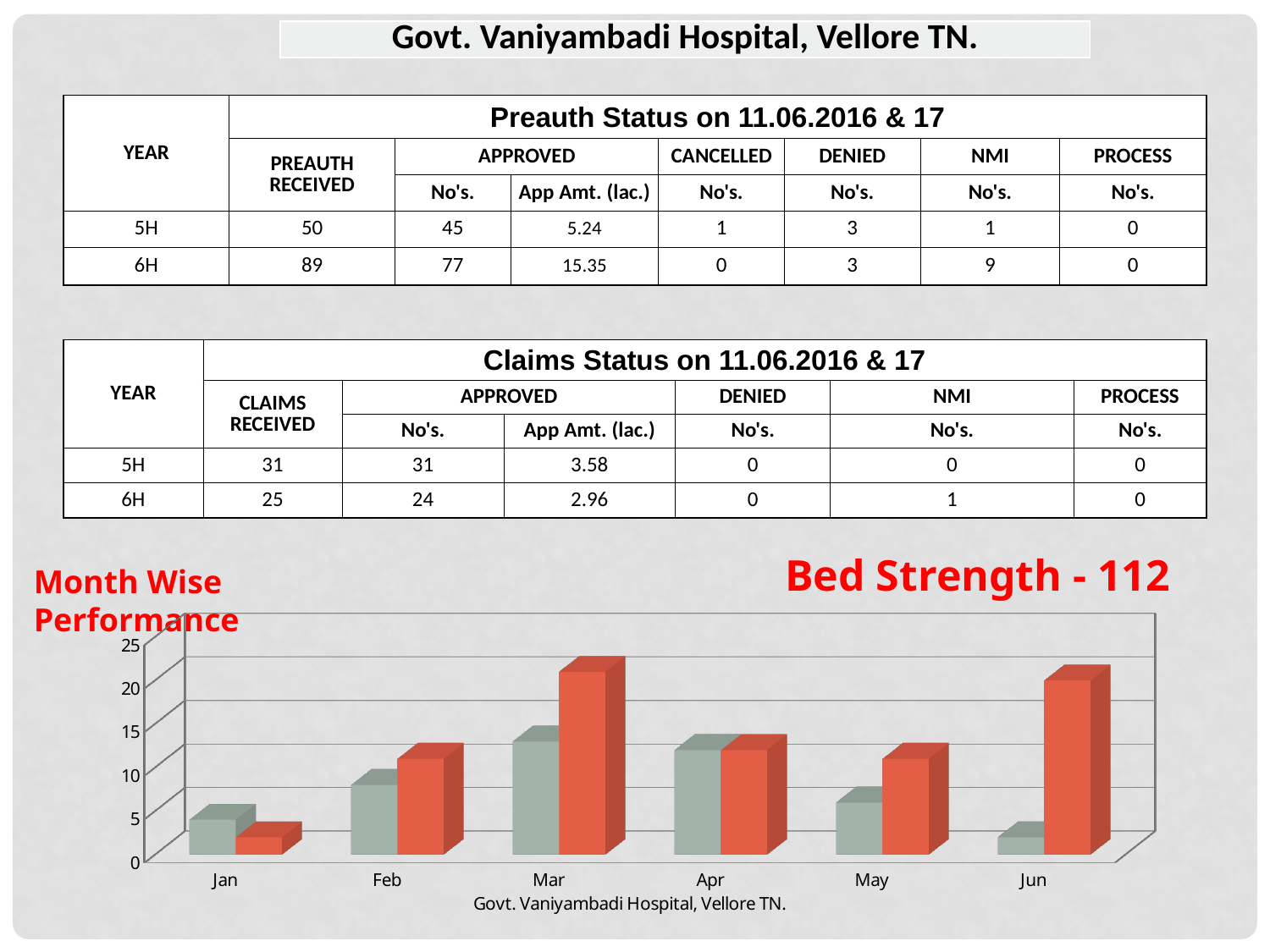
In the Month Wise Performance chart, is the grey bar for May greater or less than 10? less In the Month Wise Performance chart, which month has the lowest red bar? Jan How many months are shown on the x axis of the Month Wise Performance chart? 6 What kind of chart is shown at the bottom of the slide? bar chart In the Month Wise Performance chart, is the red bar for Jan greater or less than 5? less In the Month Wise Performance chart, which month has the lowest grey bar? Jun How many bars are plotted for each month in the Month Wise Performance chart? 2 What text appears below the x axis of the Month Wise Performance chart? Govt. Vaniyambadi Hospital, Vellore TN. In the Month Wise Performance chart, is the red bar for Mar greater or less than 15? greater In the Month Wise Performance chart, for Mar, is the red bar or the grey bar taller? red bar